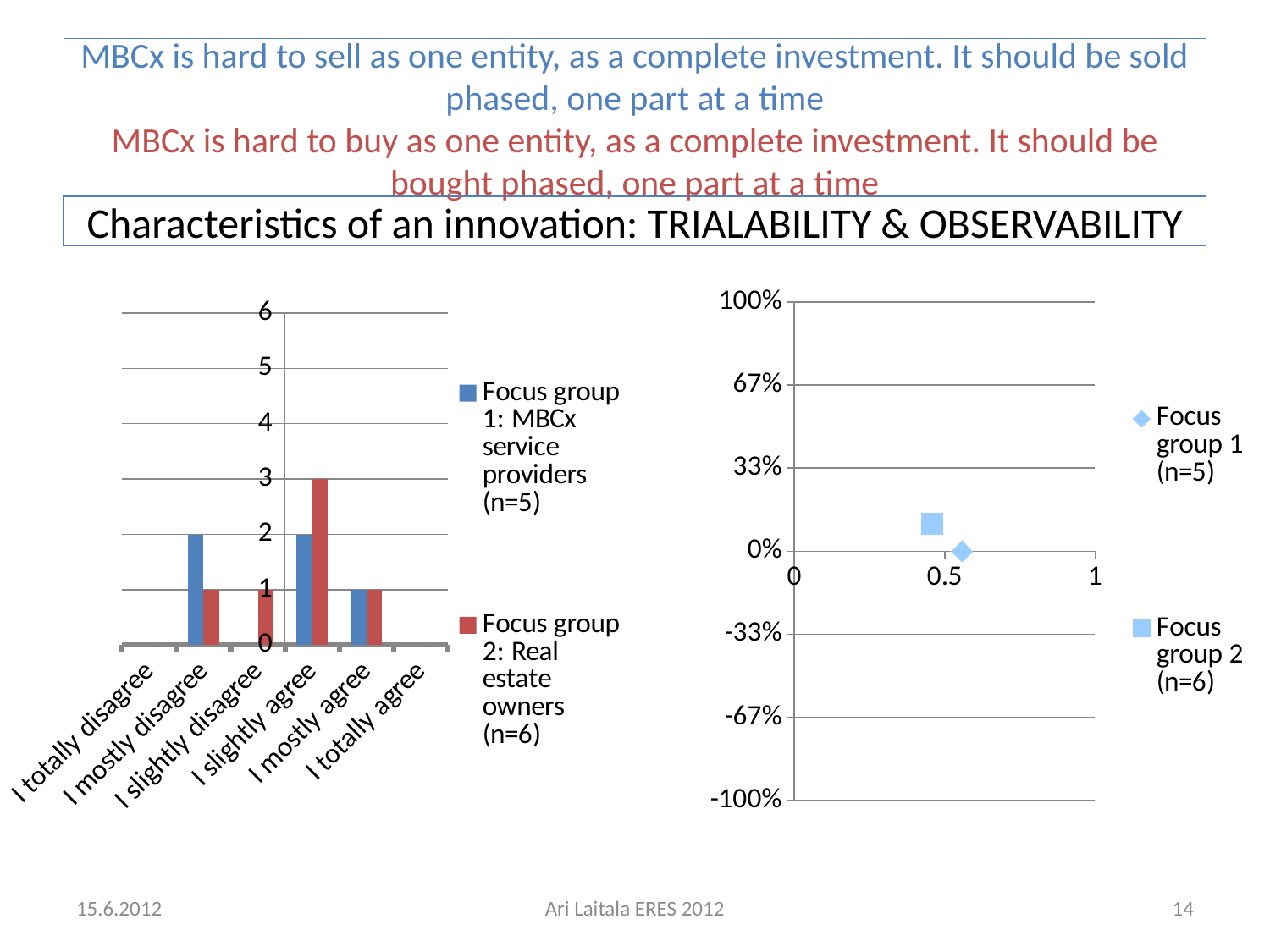
On the left bar chart, how many series does the legend list? 2 On the right scatter chart, is the vertical value for Focus group 2 (n=6) greater or less than 0%? greater On the left bar chart, what is the value for Focus group 1: MBCx service providers (n=5) for 'I mostly disagree'? 2 On the right scatter chart, which series has the higher vertical (percentage) value: Focus group 1 (n=5) or Focus group 2 (n=6)? Focus group 2 (n=6) On the left bar chart, what is the value for Focus group 2: Real estate owners (n=6) for 'I slightly disagree'? 1 On the left bar chart, what is the difference between Focus group 2 and Focus group 1 for 'I slightly agree'? 1 On the left bar chart, how many categories are shown on the x axis? 6 On the left bar chart, for 'I mostly disagree', which series has the larger value: Focus group 1 or Focus group 2? Focus group 1: MBCx service providers (n=5) What kind of chart is the chart on the left of the slide? Bar chart What kind of chart is the chart on the right of the slide? Scatter chart On the left bar chart, which category has the highest value for Focus group 2: Real estate owners (n=6)? I slightly agree On the left bar chart, what is the value for Focus group 2: Real estate owners (n=6) for 'I slightly agree'? 3